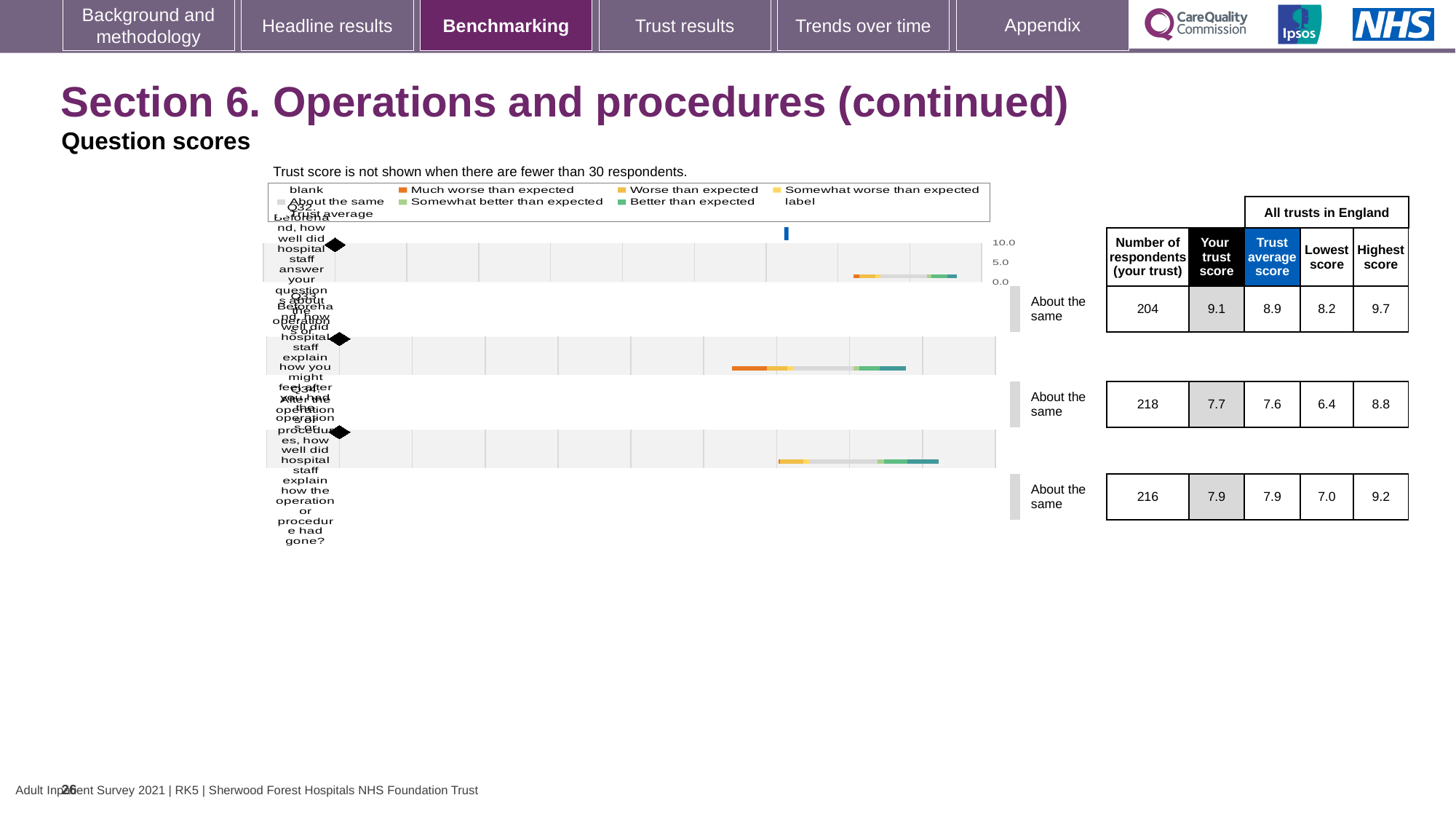
Which question row has the highest trust score? The first row (Q32), 9.1 What is the highest score across all trusts in England for the third question row? 9.2 For the second question row, is the trust score larger than the trust average score? Yes, 7.7 vs 7.6 What is the lowest score across all trusts in England for the second question row? 6.4 How many question rows are shown in the chart? 3 How many respondents answered the first question row (Q32)? 204 What rating category is shown next to each question row? About the same What is the trust average score for the second question row? 7.6 Which question row has the lowest trust score? The second row, 7.7 What is the trust score for the first question row (Q32) in the table? 9.1 What is the difference between the trust score and the trust average score for the first question row? 0.2 What kind of chart is used to show the question scores? Bar chart